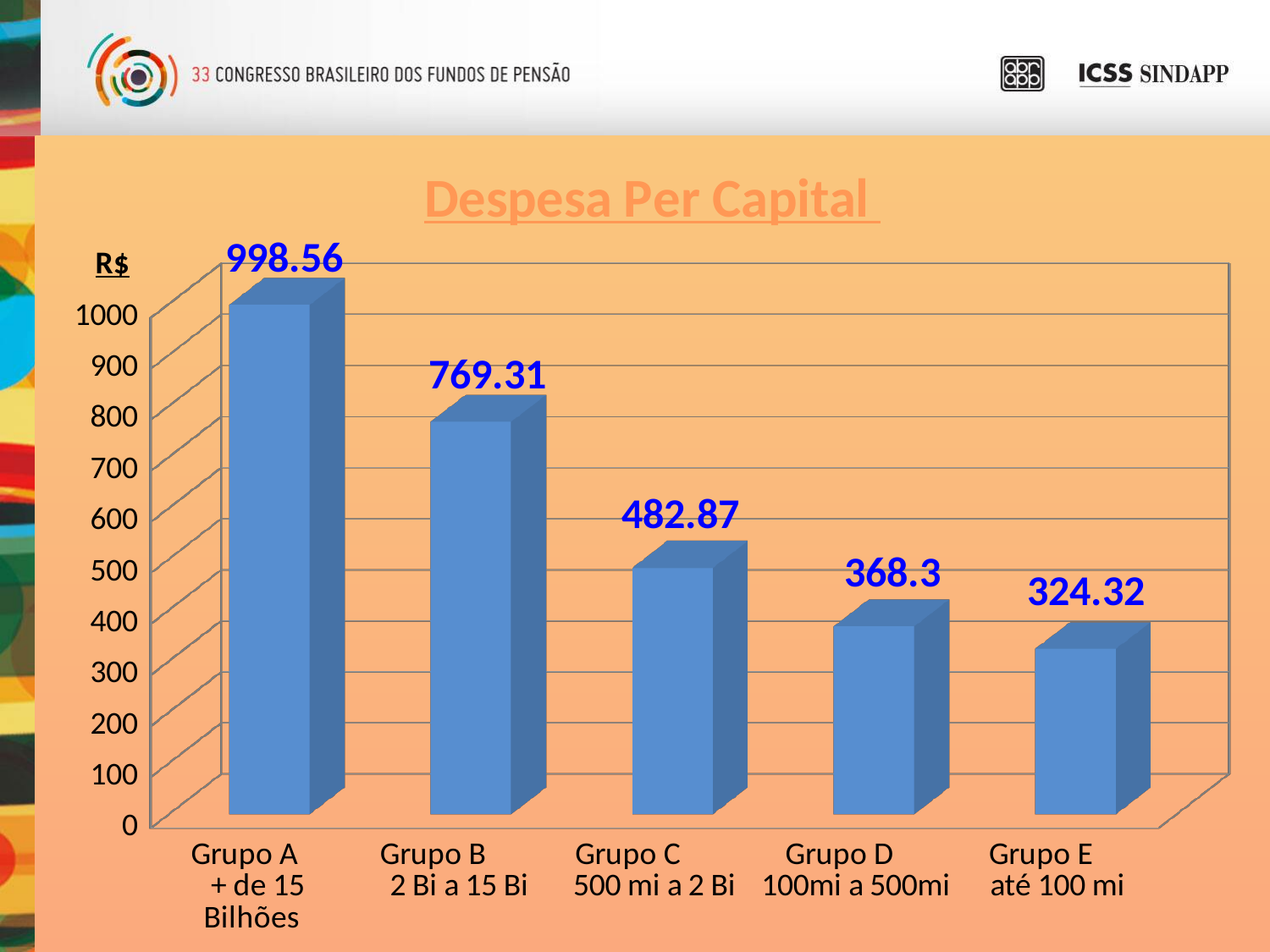
What is the value for Grupo A (+ de 15 Bilhões)? 998.56 Which is larger, the value for Grupo B or the value for Grupo C? Grupo B What is the difference between the values for Grupo A and Grupo B? 229.25 What is the difference between the values for Grupo D and Grupo E? 43.98 Do the values rise or fall from Grupo A to Grupo E? fall What is the value for Grupo E (até 100 mi)? 324.32 Is the value for Grupo D greater or less than 400? less Which group has the highest Despesa Per Capital? Grupo A What is the value for Grupo C (500 mi a 2 Bi)? 482.87 Which group has the lowest Despesa Per Capital? Grupo E How many groups are shown on the chart? 5 What kind of chart is shown on the slide? bar chart